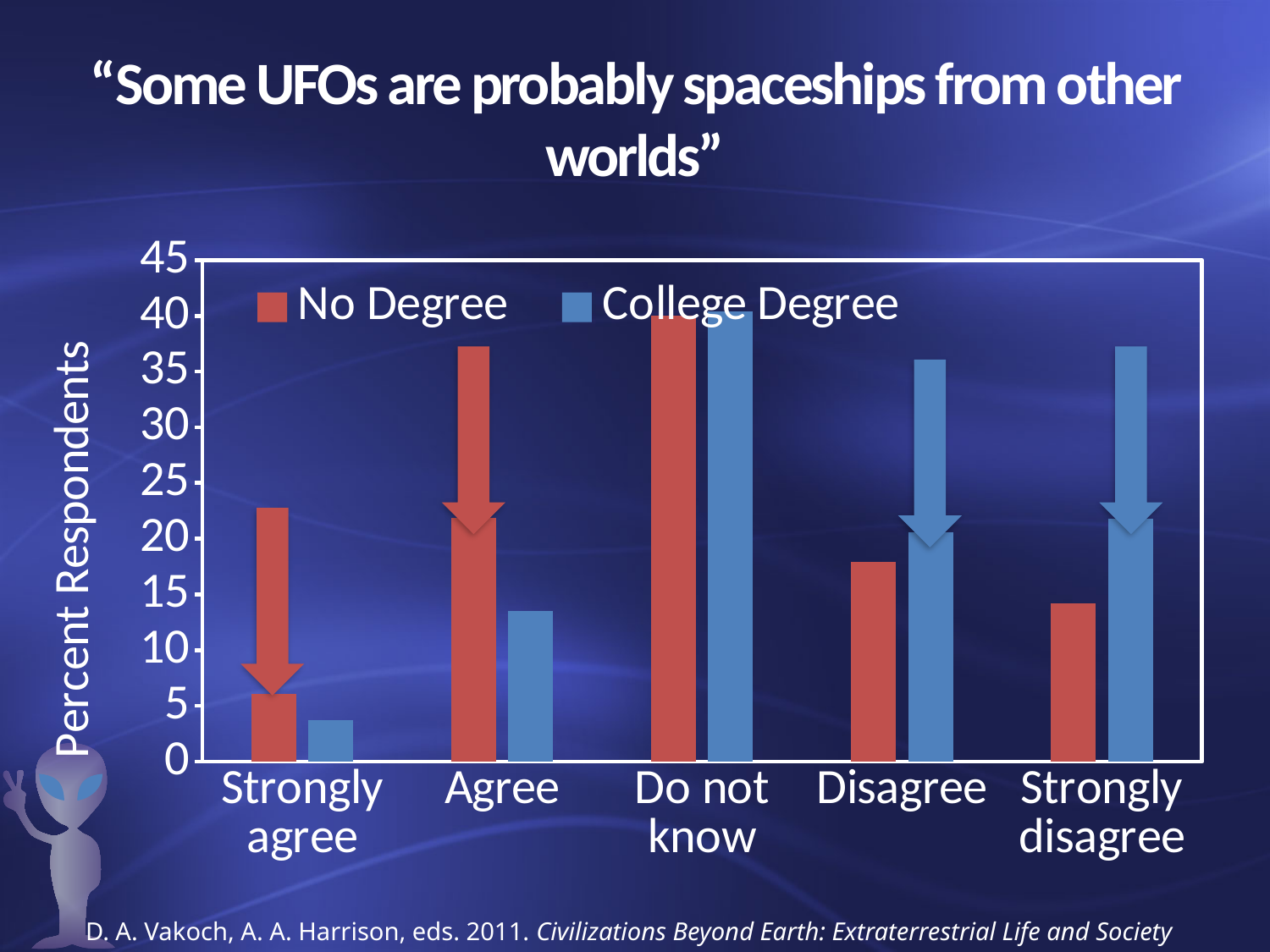
What colour represents the College Degree series in the chart? blue What kind of chart is shown on the slide? bar chart How many series does the legend list? 2 For the Disagree category, which series has the larger value, No Degree or College Degree? College Degree Is the No Degree value for Agree greater or less than 30? less Which category has the highest value for the No Degree series? Do not know Is the College Degree value for Strongly disagree greater or less than 30? less How many response categories are shown on the x axis? 5 Is the No Degree value for Strongly agree greater or less than 10? less For the Agree category, which series has the larger value, No Degree or College Degree? No Degree Which category has the lowest value for the College Degree series? Strongly agree Which category has the lowest value for the No Degree series? Strongly agree